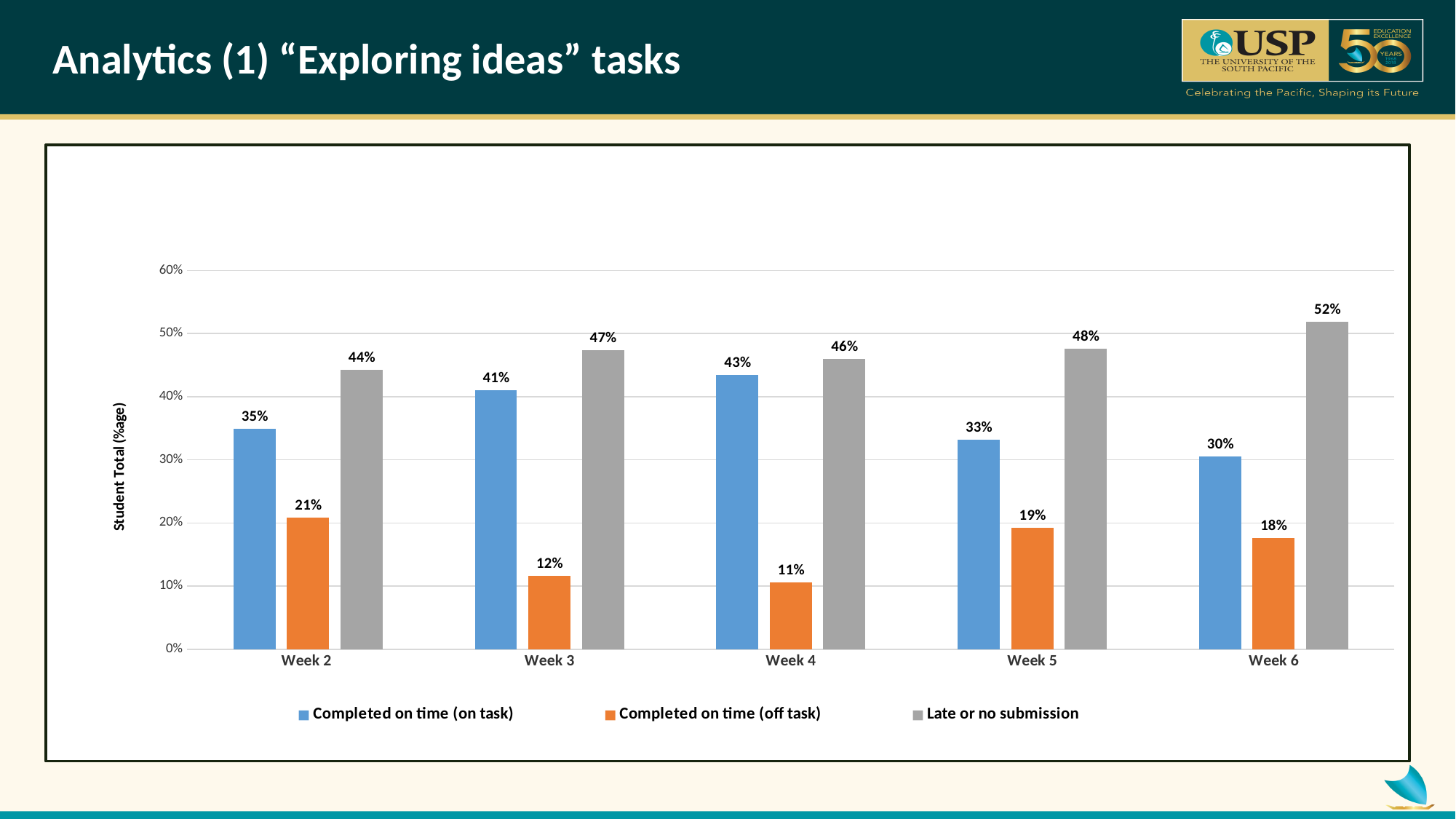
What is the value for 'Late or no submission' in Week 6? 52% What is the value for 'Completed on time (on task)' in Week 4? 43% In which week is 'Late or no submission' highest? Week 6 Is the value for 'Late or no submission' in Week 3 greater or less than 40%? greater What is the value for 'Completed on time (off task)' in Week 3? 12% How many series does the legend list? 3 How many weeks are shown on the x axis? 5 In which week is 'Completed on time (off task)' lowest? Week 4 Which is larger in Week 5: 'Completed on time (on task)' or 'Completed on time (off task)'? Completed on time (on task) What is the label of the vertical axis? Student Total (%age) What is the difference between 'Late or no submission' and 'Completed on time (on task)' in Week 2? 9% What kind of chart is shown on the slide? Bar chart